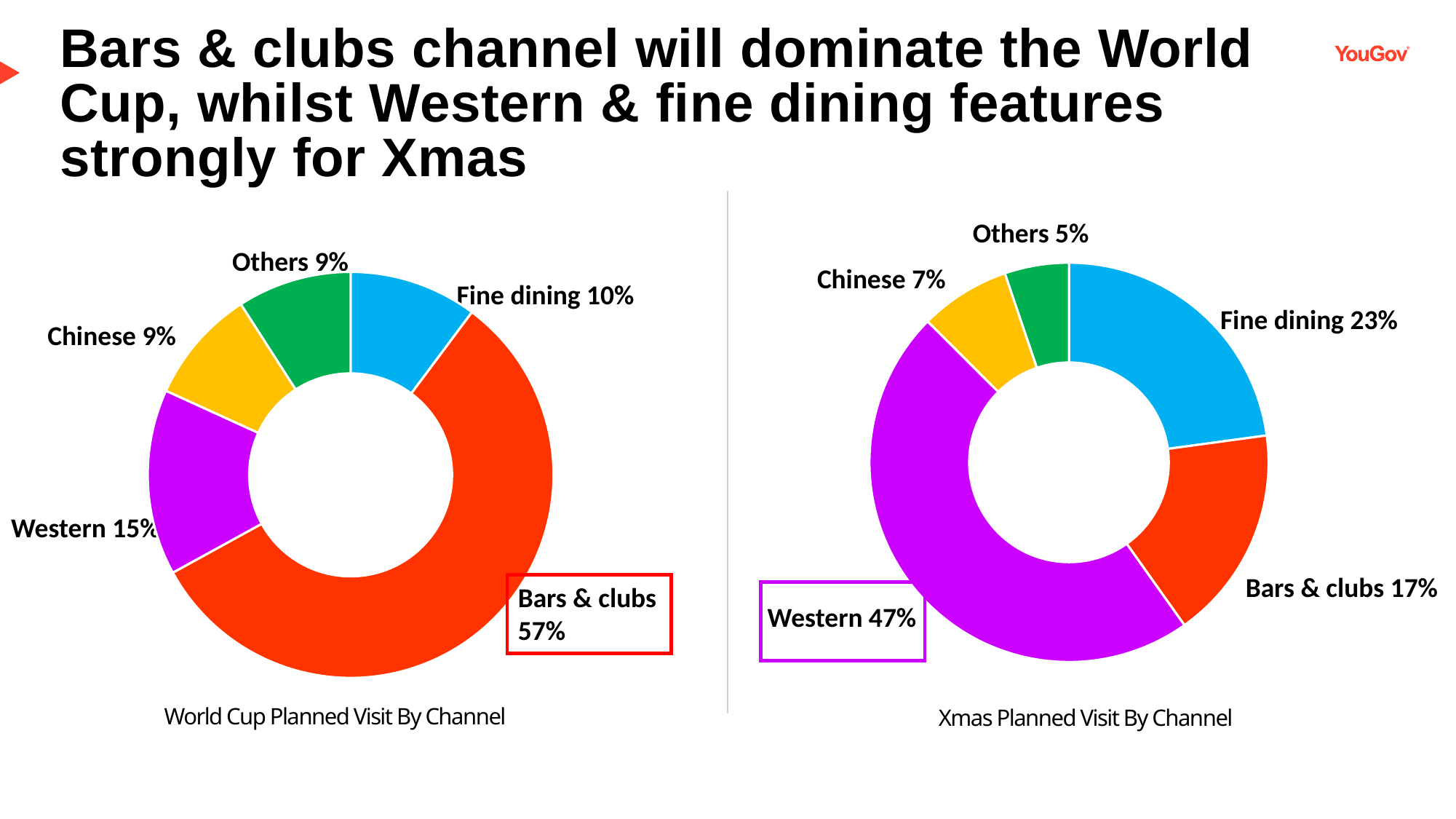
What type of chart is the Xmas Planned Visit By Channel chart? Doughnut (pie) chart In the Xmas Planned Visit By Channel chart, what share is Fine dining? 23% Which is larger: the Chinese share in the World Cup chart or the Chinese share in the Xmas chart? World Cup chart In the Xmas Planned Visit By Channel chart, what share is Western? 47% How many channel categories are shown in the World Cup Planned Visit By Channel chart? 5 What is the title of the chart on the right side of the slide? Xmas Planned Visit By Channel In the World Cup Planned Visit By Channel chart, what colour is the Bars & clubs segment? Red In the World Cup Planned Visit By Channel chart, which channel has the largest share? Bars & clubs In the Xmas Planned Visit By Channel chart, which channel has the smallest share? Others In the World Cup Planned Visit By Channel chart, what is the difference between the Western share and the Fine dining share? 5% In the World Cup Planned Visit By Channel chart, what share is Bars & clubs? 57% In the Xmas Planned Visit By Channel chart, what is the difference between the Western share and the Bars & clubs share? 30%